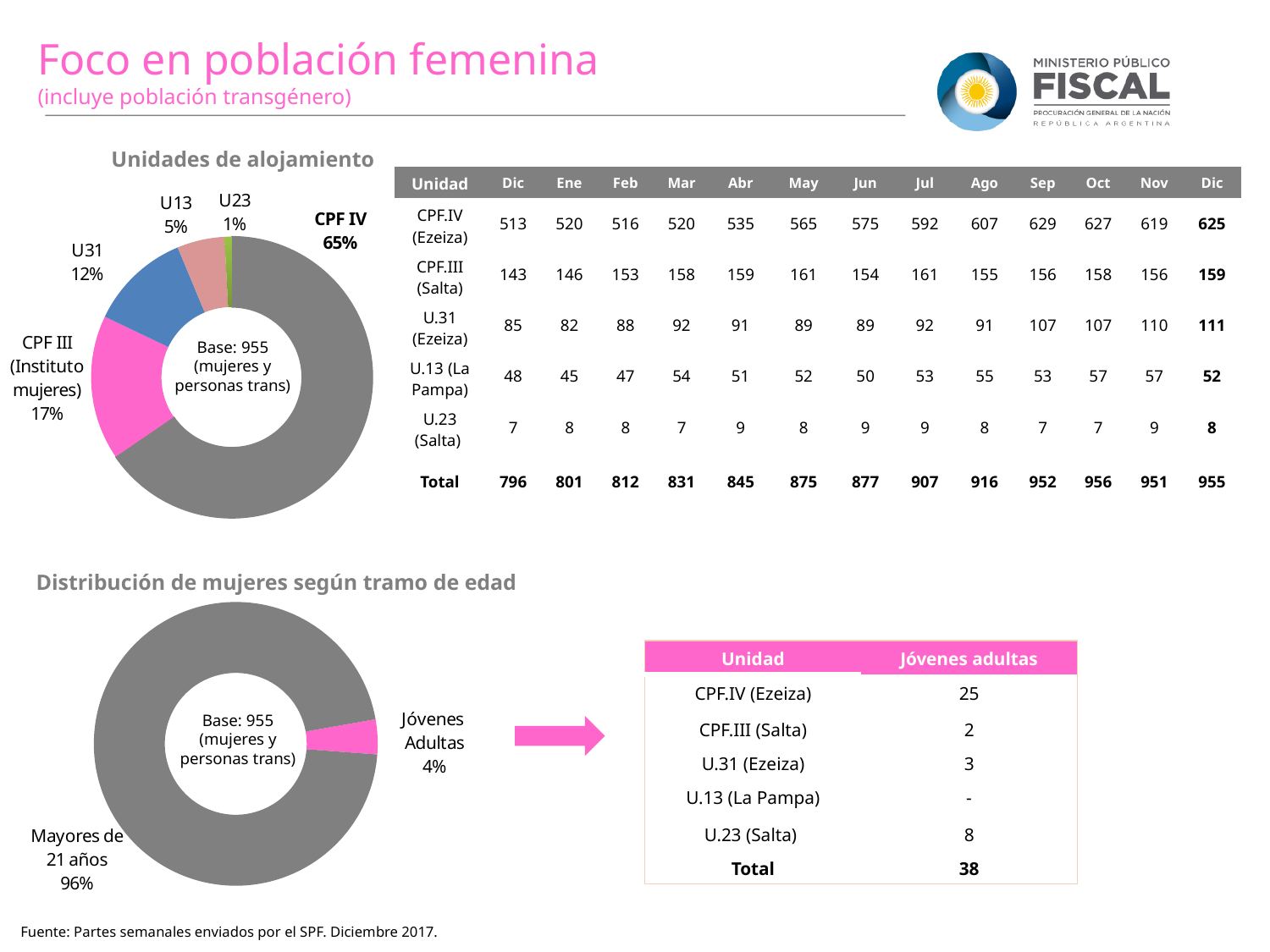
What base (total number of people) is stated in the centre of the 'Distribución de mujeres según tramo de edad' chart? 955 In the 'Unidades de alojamiento' chart, what percentage is shown for CPF III (Instituto mujeres)? 17% In the 'Unidades de alojamiento' chart, what share does CPF IV have? 65% What type of chart is 'Unidades de alojamiento'? Donut (pie) chart In the 'Distribución de mujeres según tramo de edad' chart, what share is 'Jóvenes Adultas'? 4% In the 'Unidades de alojamiento' chart, which unit has the smallest share? U23 In the 'Unidades de alojamiento' chart, which is larger, the share of U13 or the share of U23? U13 In the 'Unidades de alojamiento' chart, which unit has the largest share? CPF IV In the 'Unidades de alojamiento' chart, how many units (slices) are shown? 5 In the 'Unidades de alojamiento' chart, what is the difference in percentage points between U31 and U13? 7 In the 'Distribución de mujeres según tramo de edad' chart, what percentage is shown for 'Mayores de 21 años'? 96% In the 'Unidades de alojamiento' chart, what percentage is shown for U31? 12%